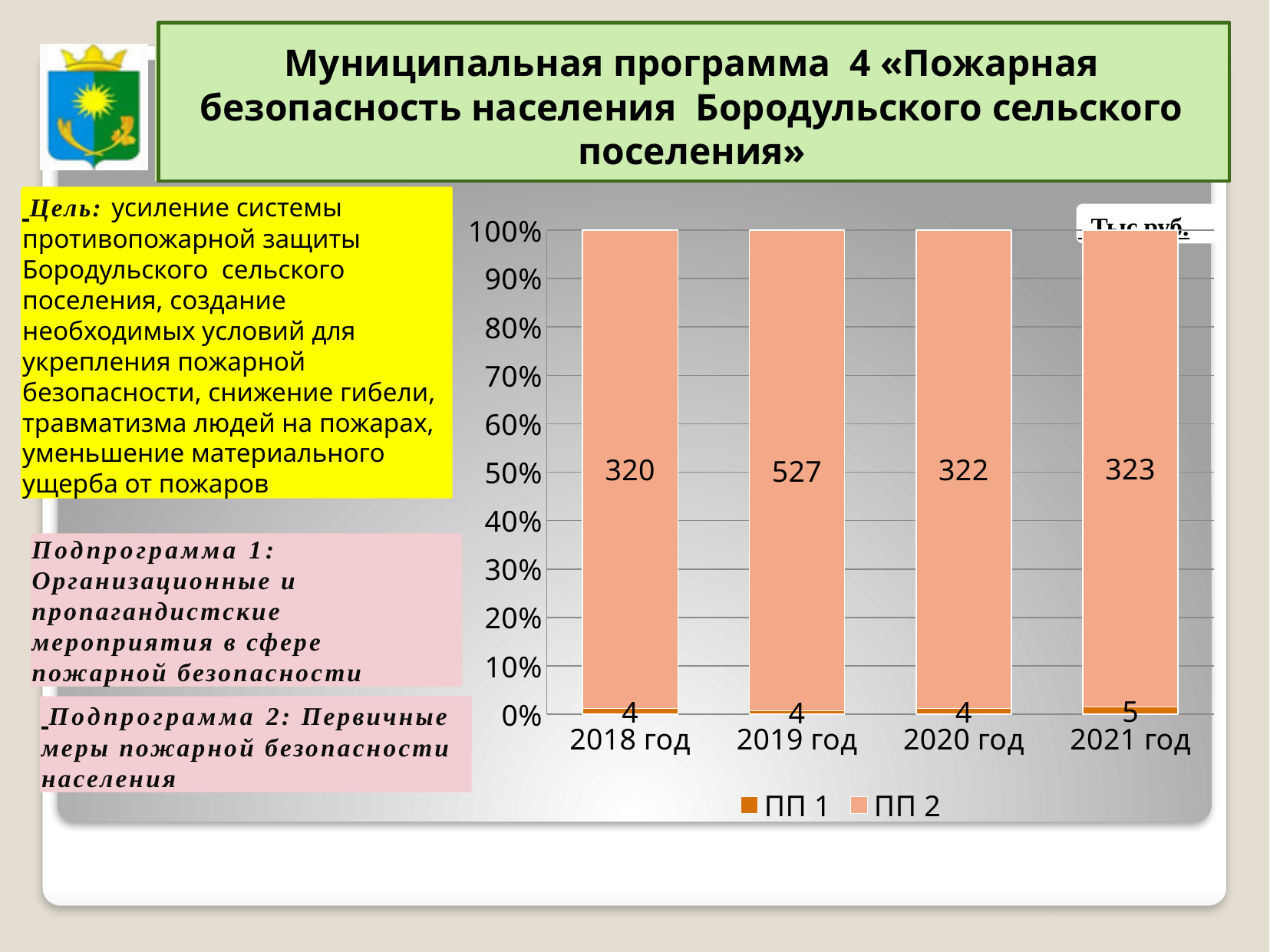
What is the value of ПП 2 for 2019 год? 527 Which is larger: the ПП 2 value for 2021 год or for 2020 год? 2021 год How many years are shown on the x axis? 4 What is the value of ПП 2 for 2018 год? 320 What kind of chart is shown on the slide? Stacked bar chart What is the difference between the ПП 2 values for 2019 год and 2020 год? 205 In which year is the value of ПП 2 the lowest? 2018 год What is the total of ПП 1 and ПП 2 for 2019 год? 531 What is the value of ПП 1 for 2021 год? 5 In which year is the value of ПП 2 the highest? 2019 год What unit is indicated in the top right corner of the chart? Тыс руб. How many series does the legend list? 2